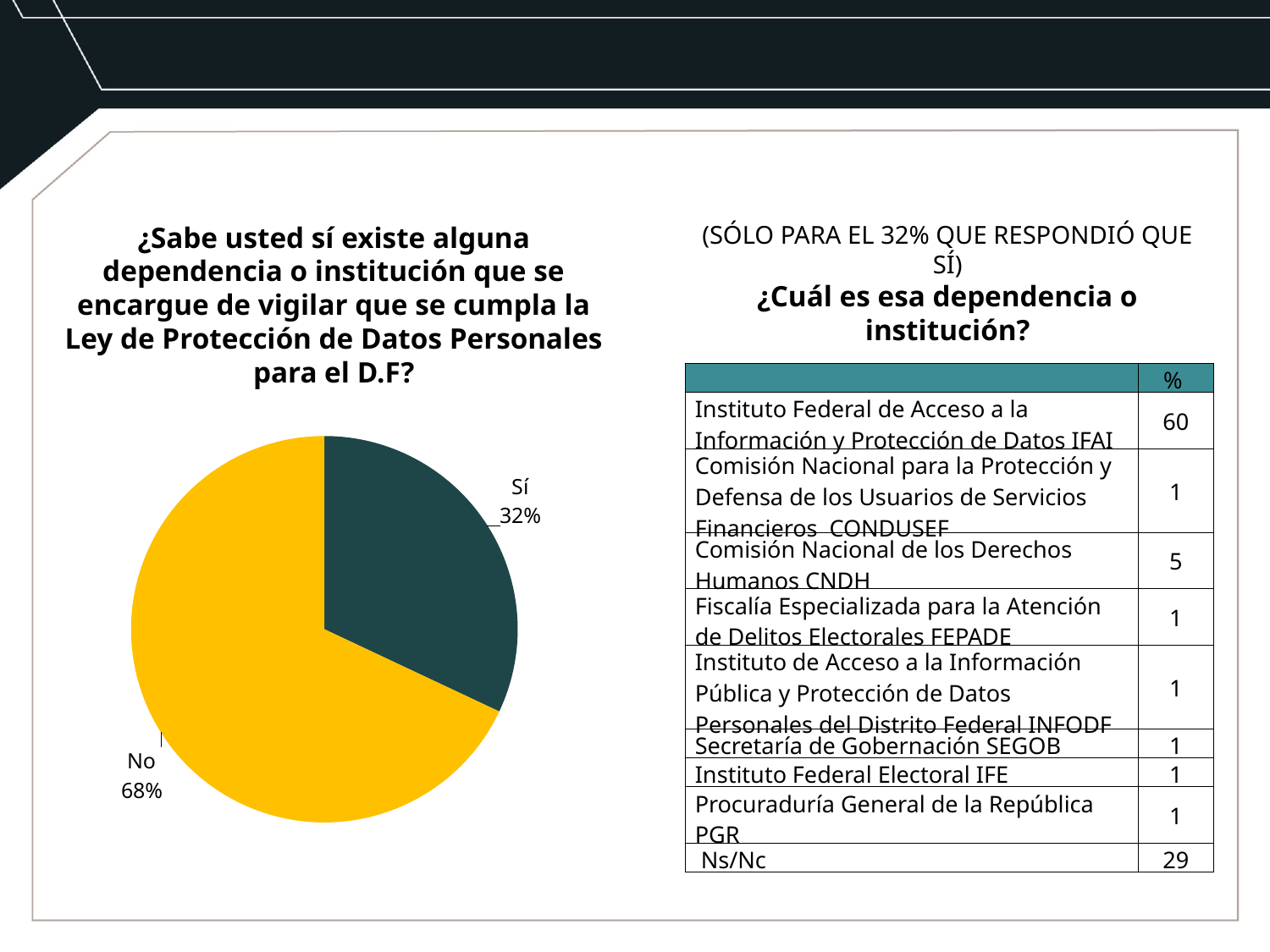
Which is larger in the pie chart, the "Sí" slice or the "No" slice? No What colour is the "No" slice of the pie chart? yellow Which slice of the pie chart is the largest? No What percentage of respondents answered "Sí" in the pie chart? 32% What percentage of respondents answered "No" in the pie chart? 68% What share of the pie does the "Sí" slice represent? 32% What is the difference in percentage points between the "No" and "Sí" slices of the pie chart? 36 What type of chart is shown on the slide? pie chart Which slice of the pie chart is the smallest? Sí How many slices does the pie chart have? 2 What colour is the "Sí" slice of the pie chart? dark teal